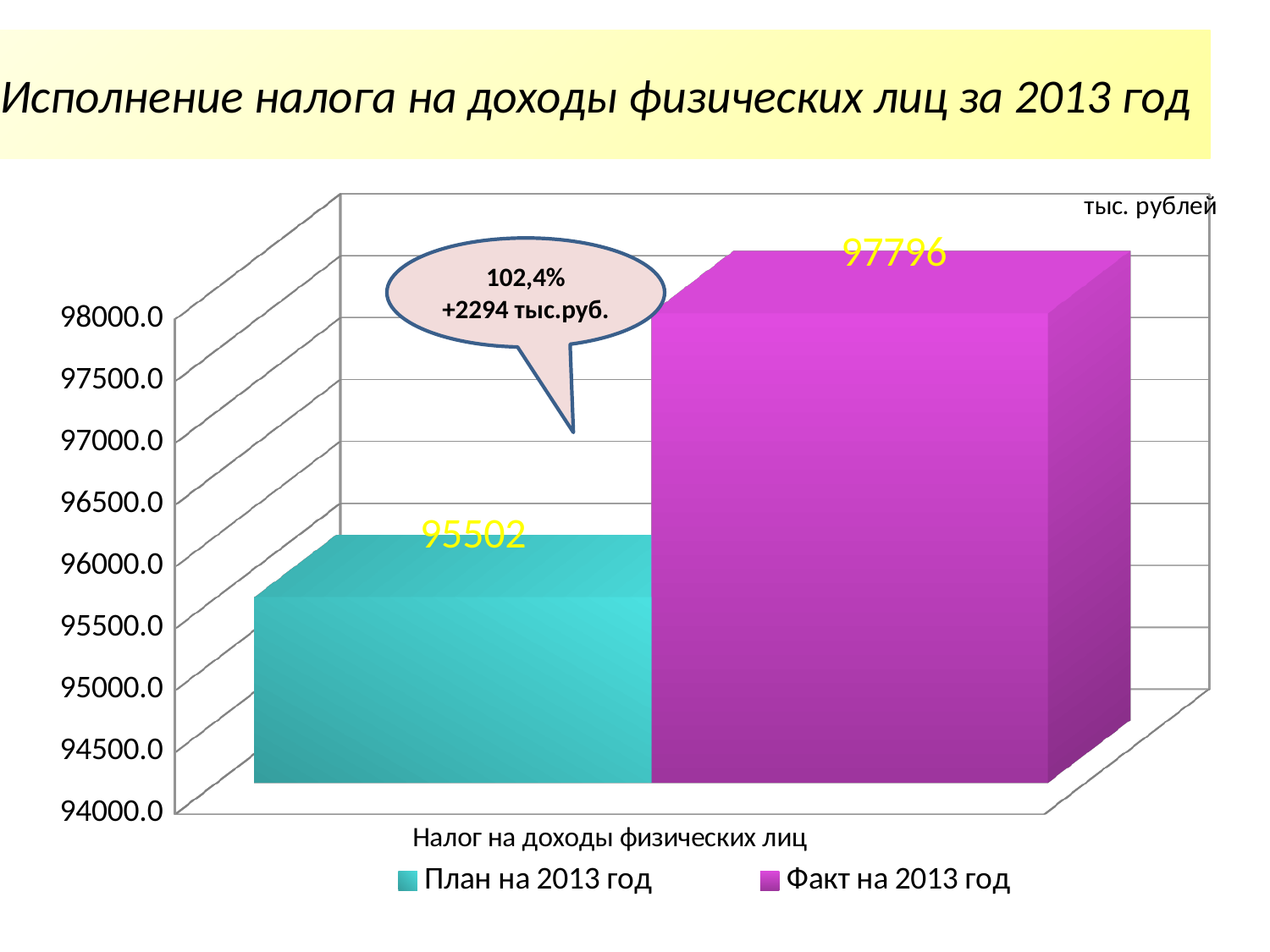
What percentage is shown in the callout on the chart? 102,4% What kind of chart is shown on the slide? bar chart Is the value for "Факт на 2013 год" greater or less than 97500.0? greater What is the value for "План на 2013 год"? 95502 What is the difference between the "Факт на 2013 год" value and the "План на 2013 год" value? 2294 How many series does the legend list? 2 What is the category label shown on the x axis? Налог на доходы физических лиц What is the title of the slide? Исполнение налога на доходы физических лиц за 2013 год Is the value for "План на 2013 год" greater or less than 96000.0? less What is the value for "Факт на 2013 год"? 97796 How many categories are shown on the x axis? 1 Which series has the higher value, "План на 2013 год" or "Факт на 2013 год"? Факт на 2013 год